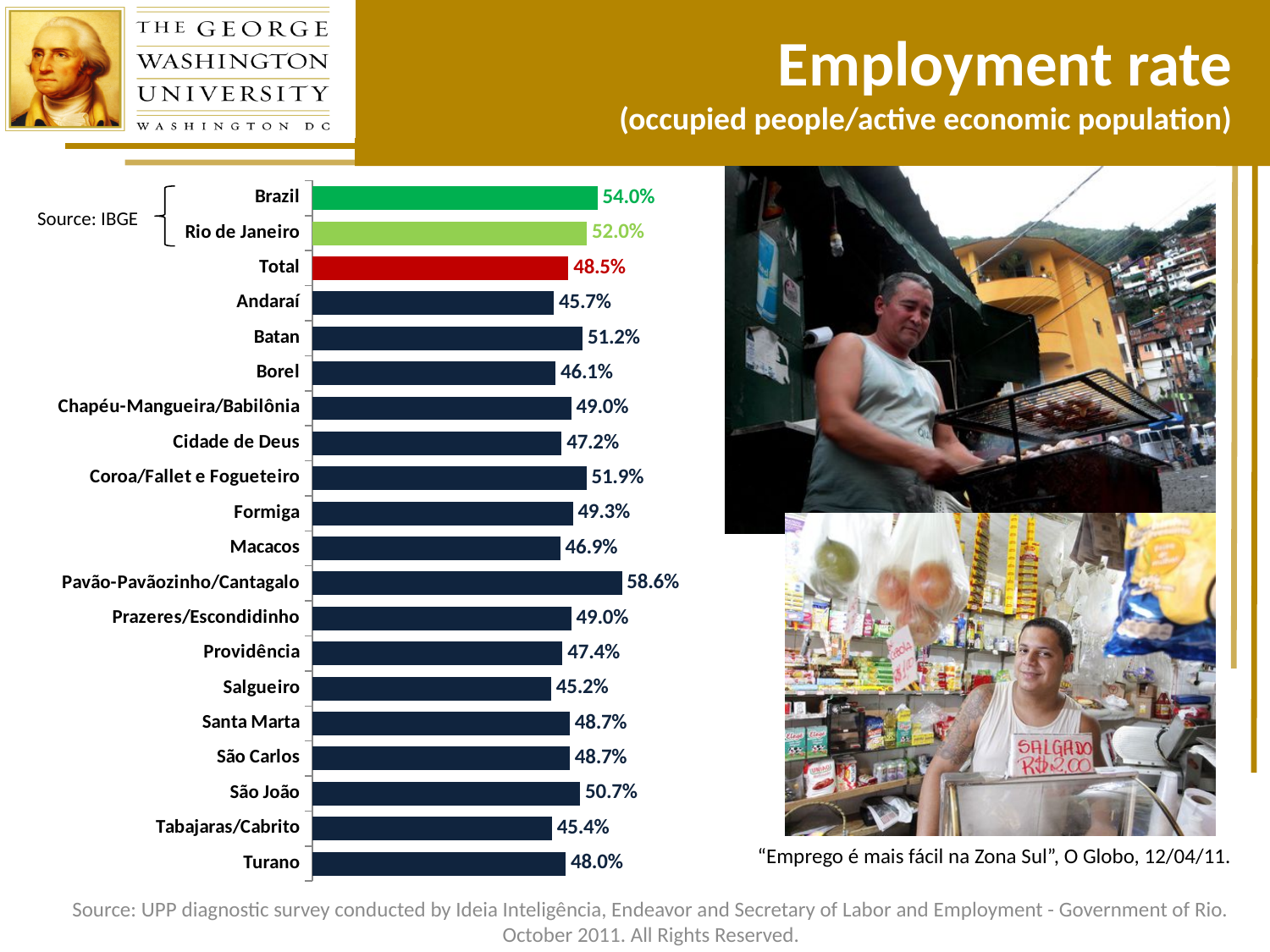
What is the difference between the employment rates of Brazil and Rio de Janeiro? 2.0% How many bars are plotted in the chart? 20 Which has a higher employment rate, Coroa/Fallet e Fogueteiro or Cidade de Deus? Coroa/Fallet e Fogueteiro What is the employment rate shown for Pavão-Pavãozinho/Cantagalo? 58.6% What is the employment rate shown for Salgueiro? 45.2% What type of chart is shown on the slide? Bar chart Which has a higher employment rate, Batan or Borel? Batan What is the employment rate shown for Brazil? 54.0% Which category has the highest employment rate in the chart? Pavão-Pavãozinho/Cantagalo Which category has the lowest employment rate in the chart? Salgueiro What is the value of the Total bar? 48.5% What is the difference between the employment rates of Pavão-Pavãozinho/Cantagalo and Total? 10.1%